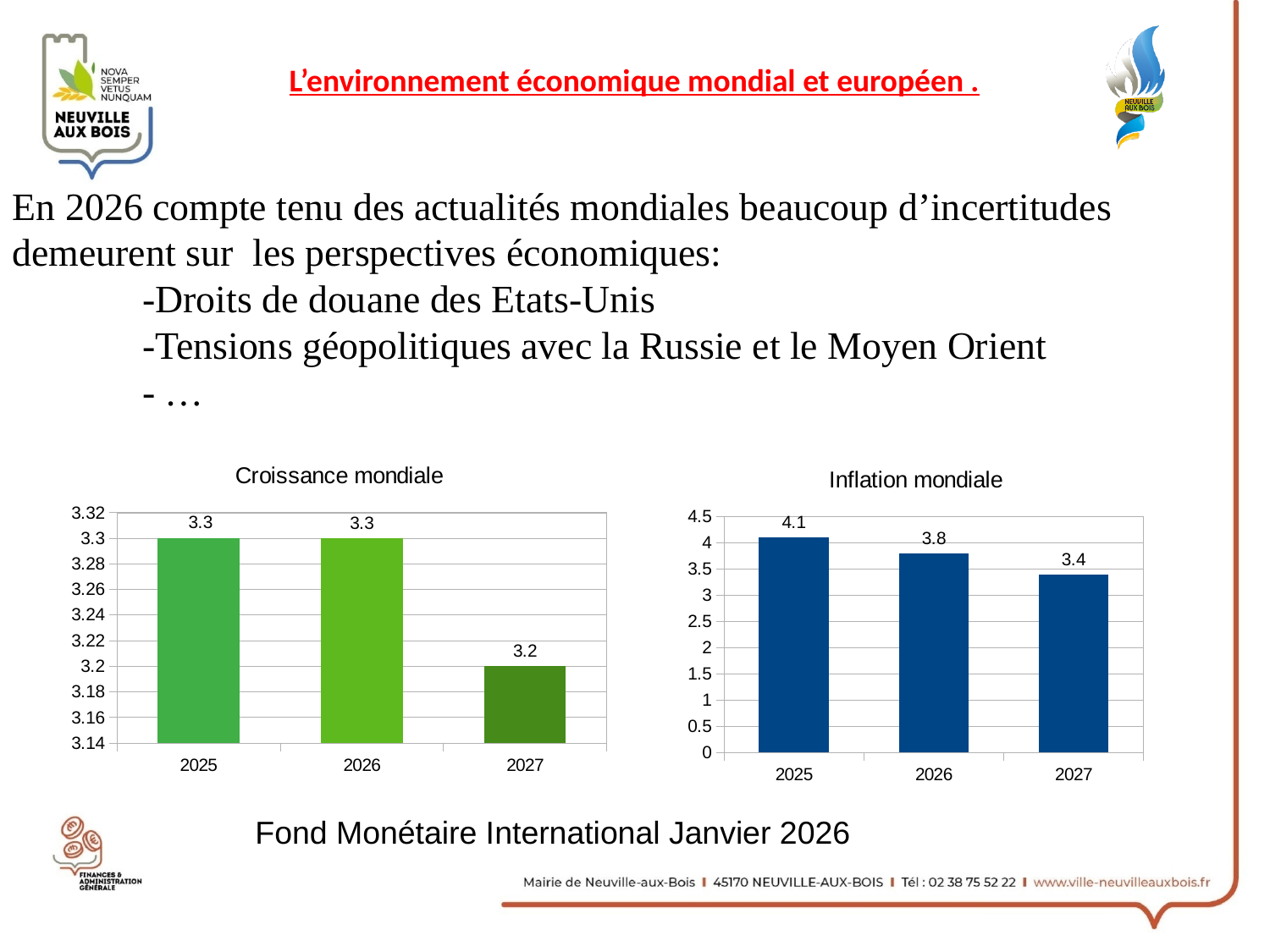
In the 'Inflation mondiale' chart, what is the value for 2026? 3.8 In the 'Croissance mondiale' chart, which year has the lowest value? 2027 In the 'Croissance mondiale' chart, what is the difference between the 2026 and 2027 values? 0.1 In the 'Inflation mondiale' chart, what is the difference between the 2025 and 2027 values? 0.7 In the 'Inflation mondiale' chart, is the value for 2025 greater or less than 4? greater In the 'Inflation mondiale' chart, which year has the highest value? 2025 What kind of chart is the 'Croissance mondiale' chart? bar chart In the 'Croissance mondiale' chart, what is the value for 2025? 3.3 In the 'Inflation mondiale' chart, what is the value for 2027? 3.4 In the 'Croissance mondiale' chart, what is the value for 2027? 3.2 How many years are shown in the 'Inflation mondiale' chart? 3 In the 'Inflation mondiale' chart, do the values rise or fall from 2025 to 2027? fall